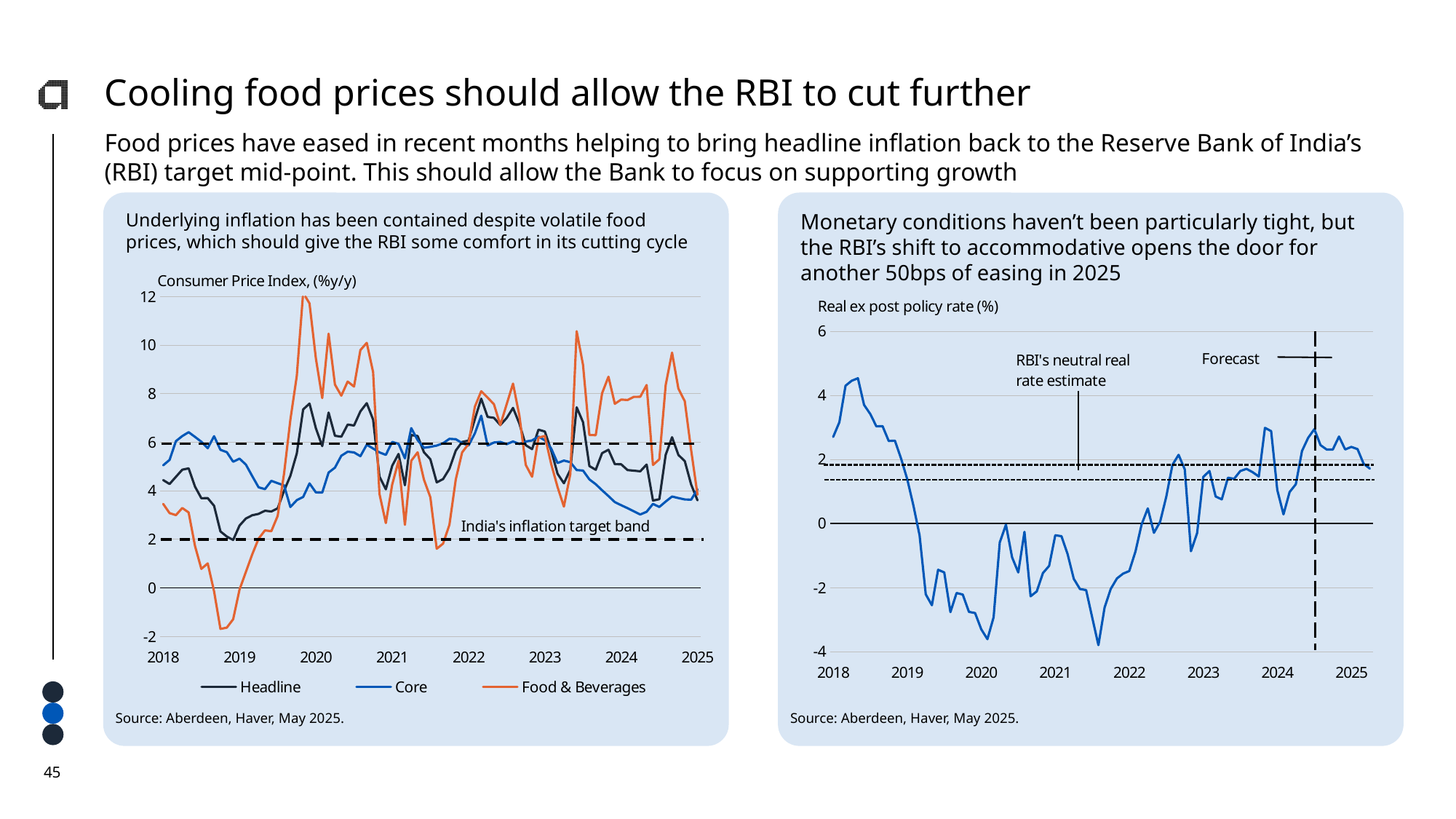
In the left chart, 'Consumer Price Index, (%y/y)', is the peak value of Food & Beverages around the start of 2020 greater or less than 10? greater In the right chart, 'Real ex post policy rate (%)', does the real policy rate rise or fall between 2021 and 2023? rise What kind of chart is the left chart, 'Consumer Price Index, (%y/y)'? line chart In the right chart, 'Real ex post policy rate (%)', does the real policy rate rise or fall between 2018 and 2020? fall What kind of chart is the right chart, 'Real ex post policy rate (%)'? line chart In the left chart, 'Consumer Price Index, (%y/y)', what are the two levels marked by the dashed lines labelled 'India's inflation target band'? 2 and 6 In the right chart, 'Real ex post policy rate (%)', is the value at the start of 2018 greater or less than 2? greater How many year labels are shown on the x axis of the left chart, 'Consumer Price Index, (%y/y)'? 8 In the right chart, 'Real ex post policy rate (%)', is the lowest value in 2021 greater or less than -2? less How many series does the legend of the left chart, 'Consumer Price Index, (%y/y)', list? 3 In the left chart, 'Consumer Price Index, (%y/y)', which series is drawn in orange? Food & Beverages